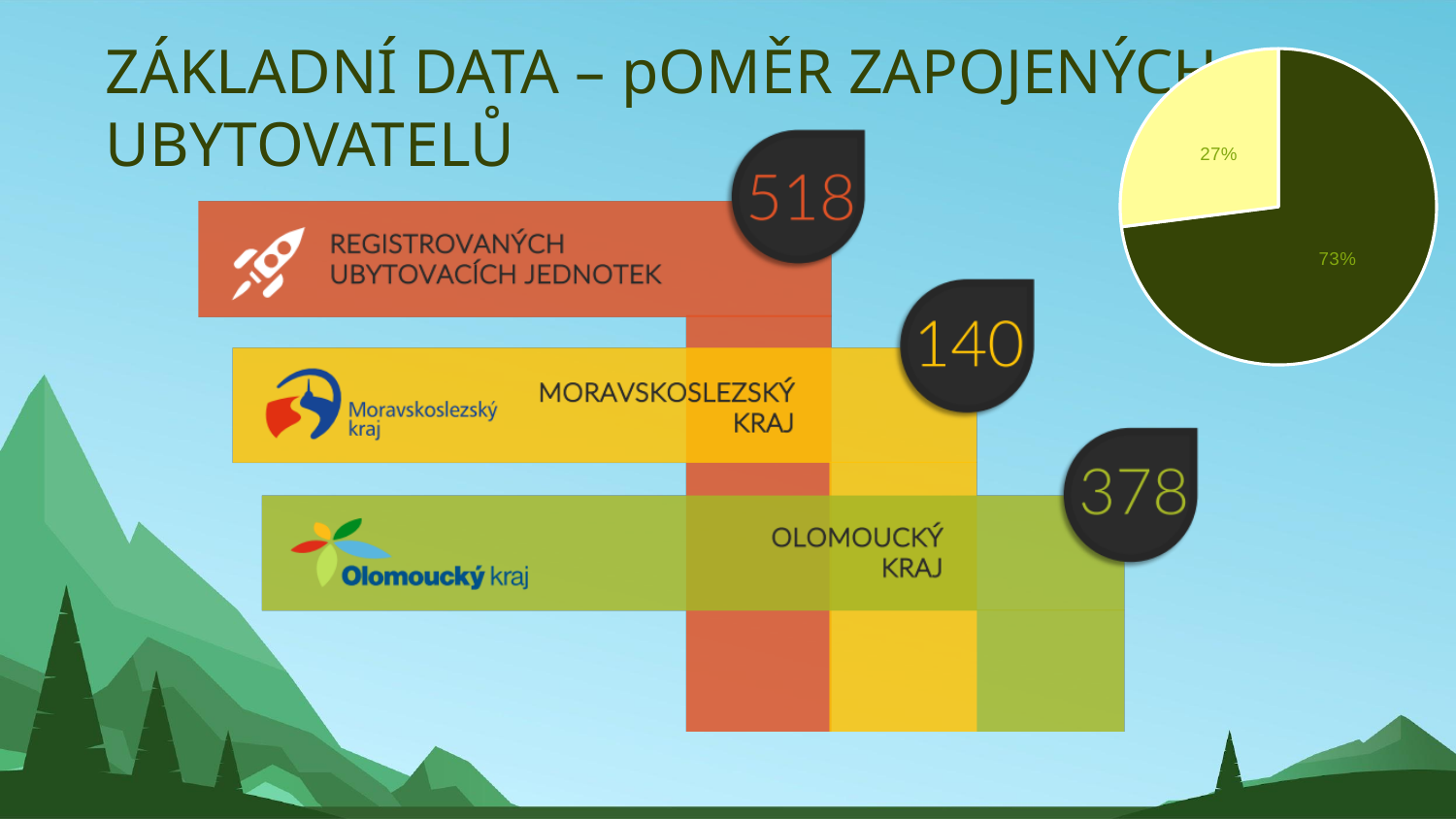
What kind of chart is shown in the top right of the slide? pie chart In the infographic on the left, what number is shown for Moravskoslezský kraj? 140 Does the pie chart display a legend? No In the infographic on the left, what number is shown for registered accommodation units (Registrovaných ubytovacích jednotek)? 518 What share does the smallest slice of the pie chart represent? 27% What is the difference in percentage points between the two slices of the pie chart? 46 What colour is the slice labelled 27% in the pie chart? light yellow What share does the largest slice of the pie chart represent? 73% Is the share of the dark green slice in the pie chart greater or less than 50%? greater Which slice of the pie chart is larger, the dark green one or the light yellow one? the dark green one How many slices does the pie chart have? 2 In the infographic on the left, what number is shown for Olomoucký kraj? 378